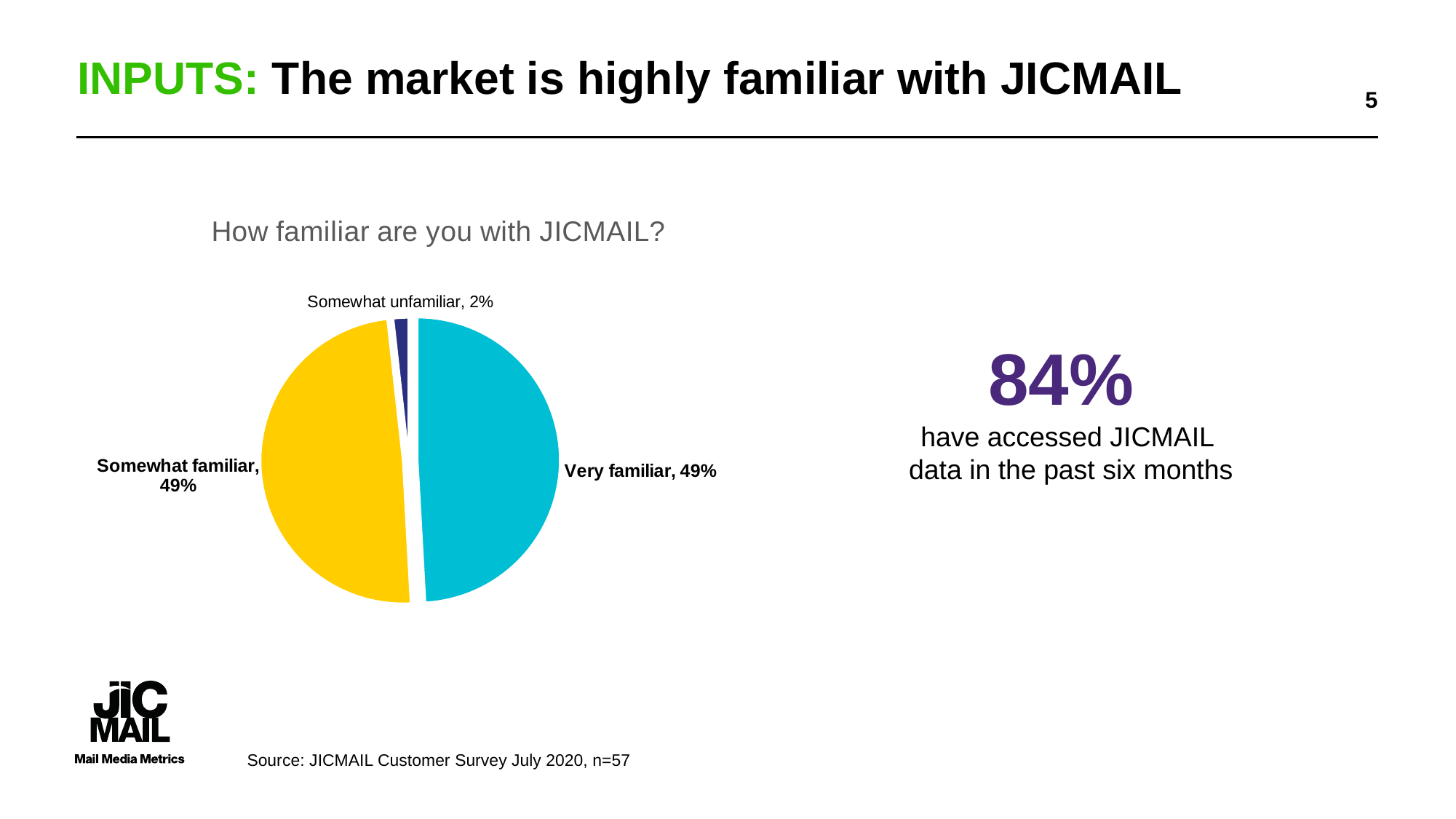
What colour is the Very familiar slice of the pie? Blue What percentage of respondents are somewhat familiar with JICMAIL? 49% Is the share for Somewhat unfamiliar greater or less than 10%? less What is the difference between the share for Very familiar and the share for Somewhat unfamiliar? 47% How many slices does the pie chart have? 3 What percentage of respondents are very familiar with JICMAIL? 49% What percentage of respondents are somewhat unfamiliar with JICMAIL? 2% What is the combined share of respondents who are very familiar or somewhat familiar with JICMAIL? 98% Which is larger, the share for Very familiar or the share for Somewhat unfamiliar? Very familiar What question does the pie chart's title ask? How familiar are you with JICMAIL? What kind of chart is shown on the slide? pie chart Which category has the smallest slice of the pie? Somewhat unfamiliar